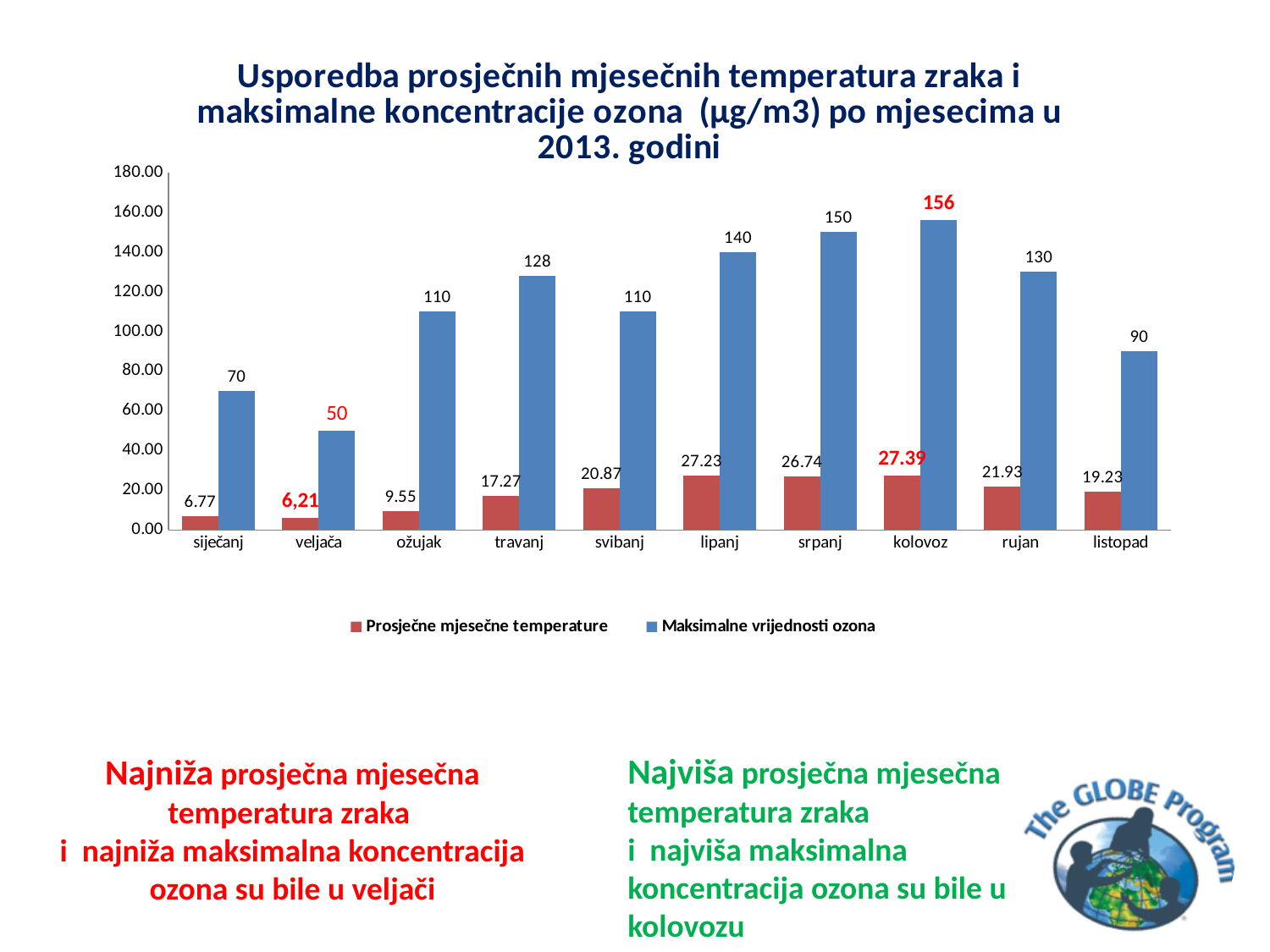
Is the maximum ozone value for lipanj greater or less than 120.00? greater How many months are shown on the x axis? 10 How many series does the legend list? 2 What kind of chart is shown on the slide? bar chart Which colour represents the Maksimalne vrijednosti ozona series? blue Which month has the highest maximum ozone value? kolovoz What is the maximum ozone value for listopad? 90 Which month has the lowest average monthly temperature? veljača What is the maximum ozone value (Maksimalne vrijednosti ozona) for kolovoz? 156 Which is larger, the maximum ozone value for travanj or for rujan? rujan What is the difference between the maximum ozone values for srpanj and sijecanj? 80 What is the average monthly temperature (Prosječne mjesečne temperature) for lipanj? 27.23